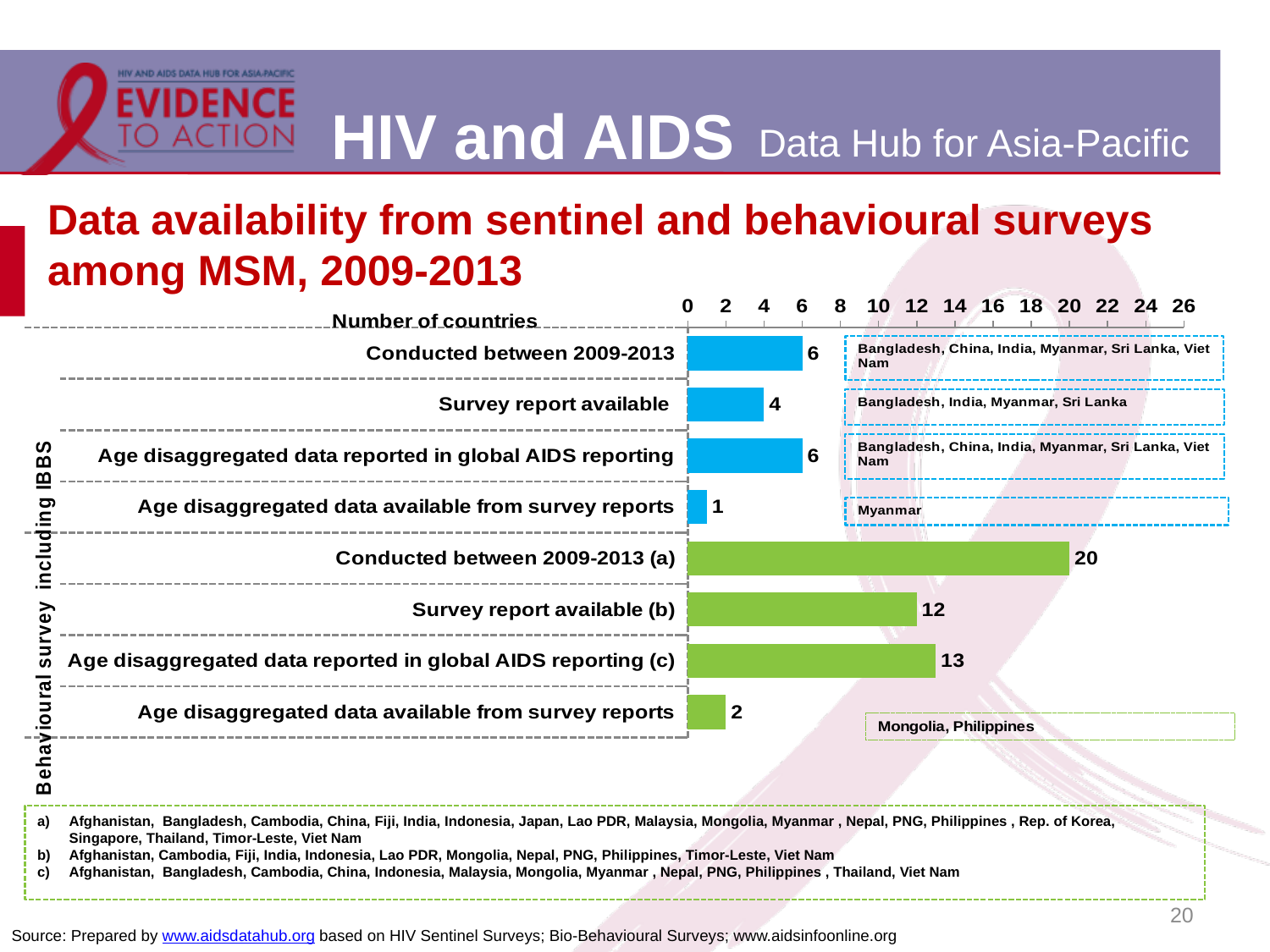
What type of chart is shown on the slide? bar chart What is the value for 'Survey report available' in the IBBS group (blue bar)? 4 Which countries are listed next to the 'Age disaggregated data available from survey reports' bar in the Behavioural survey group? Mongolia, Philippines Which category has the highest value in the chart? Conducted between 2009-2013 (a) What is the value for 'Survey report available (b)'? 12 Which category has the lowest value in the chart? Age disaggregated data available from survey reports (the blue bar, value 1) What is the value for 'Age disaggregated data reported in global AIDS reporting (c)'? 13 What is the value for 'Age disaggregated data available from survey reports' in the IBBS group (blue bar)? 1 How many categories (bars) are plotted in the chart? 8 What is the difference between 'Conducted between 2009-2013 (a)' and 'Survey report available (b)'? 8 What is the value for 'Conducted between 2009-2013 (a)'? 20 Which is larger: 'Survey report available (b)' or 'Age disaggregated data reported in global AIDS reporting (c)'? Age disaggregated data reported in global AIDS reporting (c)